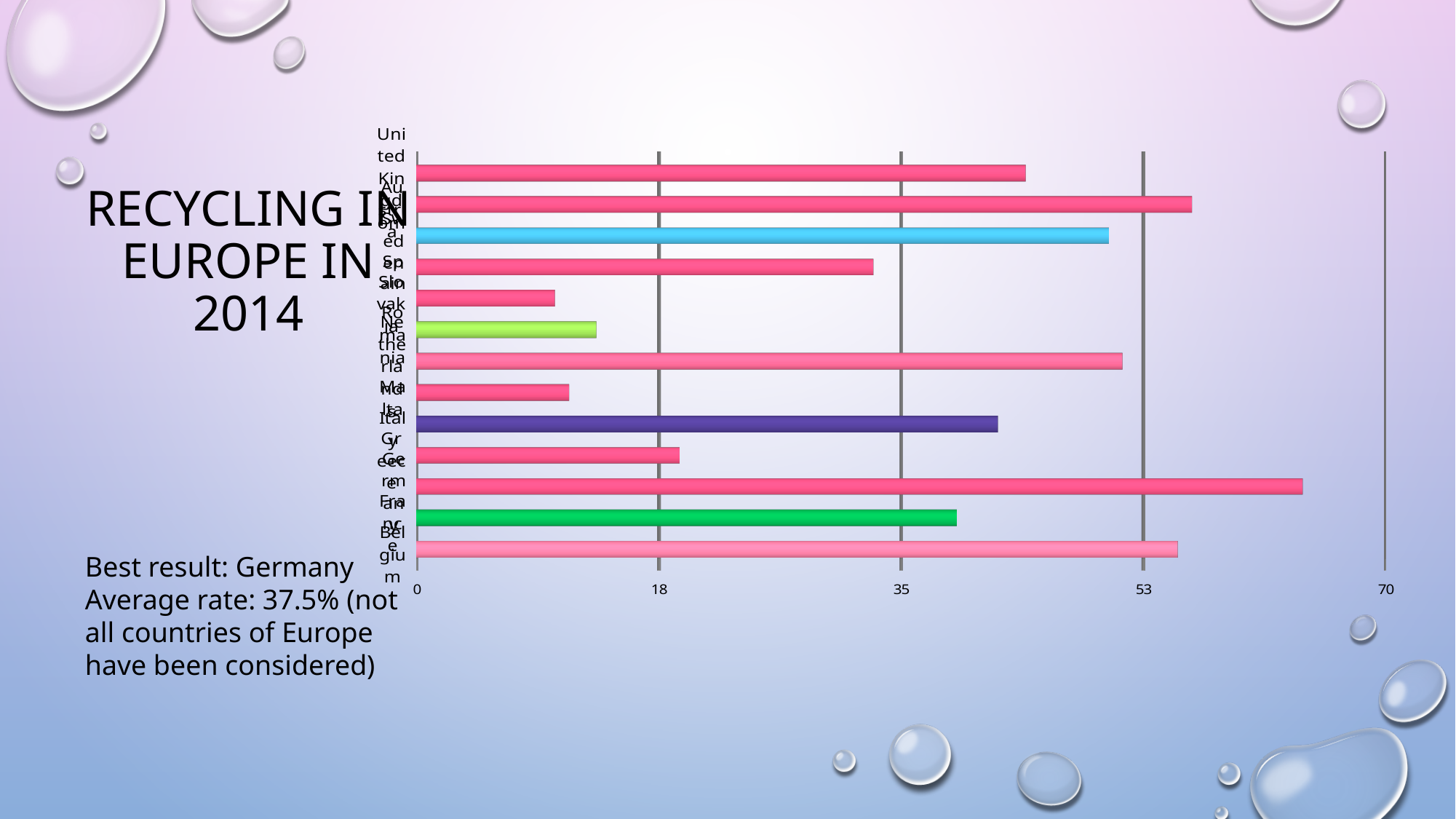
Which has the longer bar, United Kingdom or Belgium? Belgium How many bars (countries) are plotted in the chart? 13 What is the highest tick value shown on the horizontal axis of the chart? 70 Is the value for United Kingdom greater or less than 35? greater What kind of chart is shown on the slide? bar chart What is the title of the slide containing the chart? Recycling in Europe in 2014 Is the value for Belgium greater or less than 70? less Is the value for Belgium greater or less than 35? greater According to the slide, which country has the best (highest) recycling result? Germany